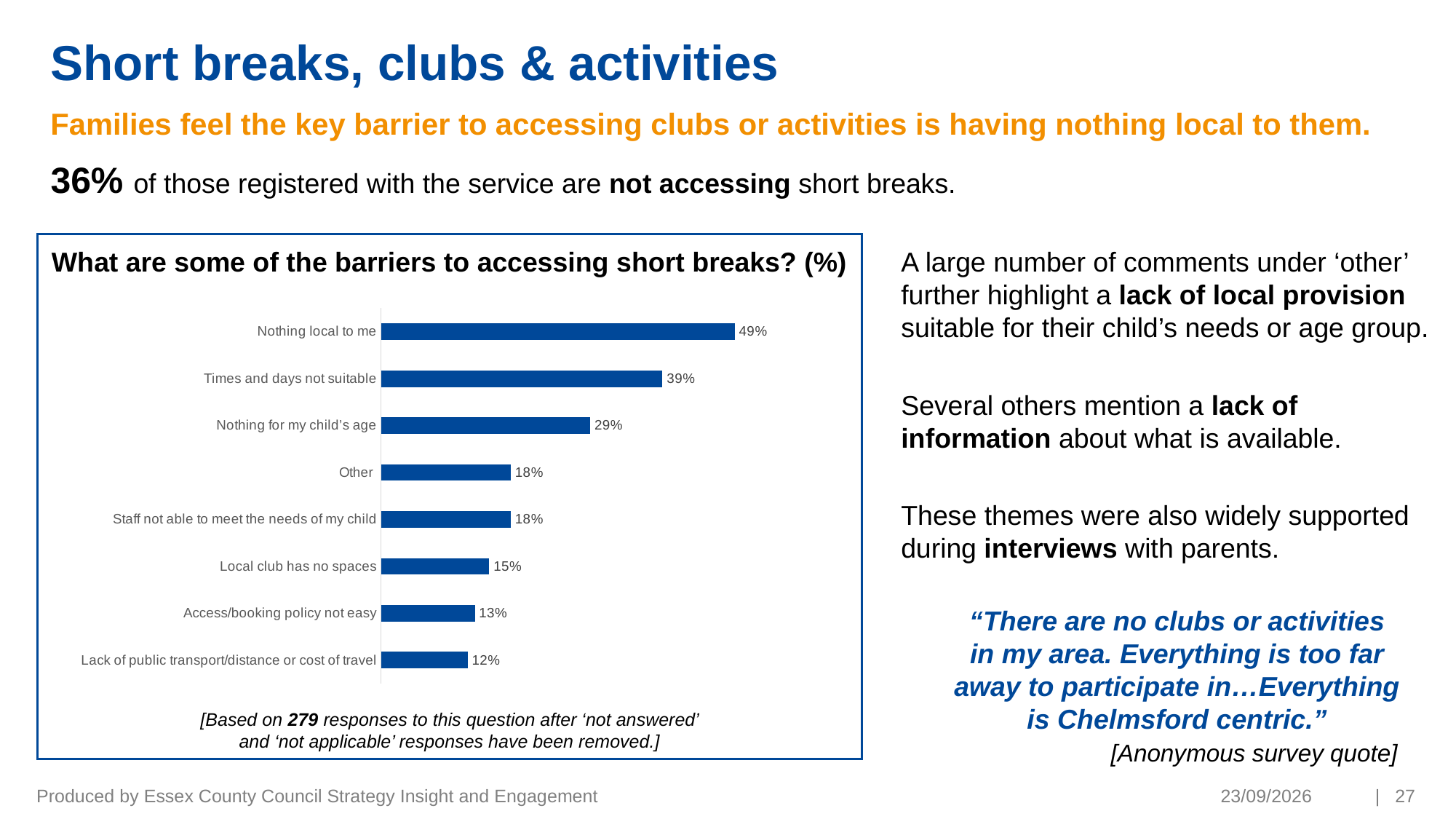
What type of chart is used to show the barriers to accessing short breaks? Bar chart What is the value shown for 'Times and days not suitable'? 39% What is the difference in percentage points between 'Nothing local to me' and 'Times and days not suitable'? 10 What is the value for 'Lack of public transport/distance or cost of travel'? 12% Which barrier has the lowest percentage in the chart? Lack of public transport/distance or cost of travel What is the difference in percentage points between 'Nothing for my child's age' and 'Access/booking policy not easy'? 16 What is the title of the chart? What are some of the barriers to accessing short breaks? (%) Which is larger: the value for 'Local club has no spaces' or the value for 'Access/booking policy not easy'? Local club has no spaces Which barrier has the highest percentage in the chart? Nothing local to me What percentage is shown for 'Local club has no spaces'? 15% What percentage of respondents cited 'Nothing local to me' as a barrier to accessing short breaks? 49% How many barrier categories are shown in the chart? 8